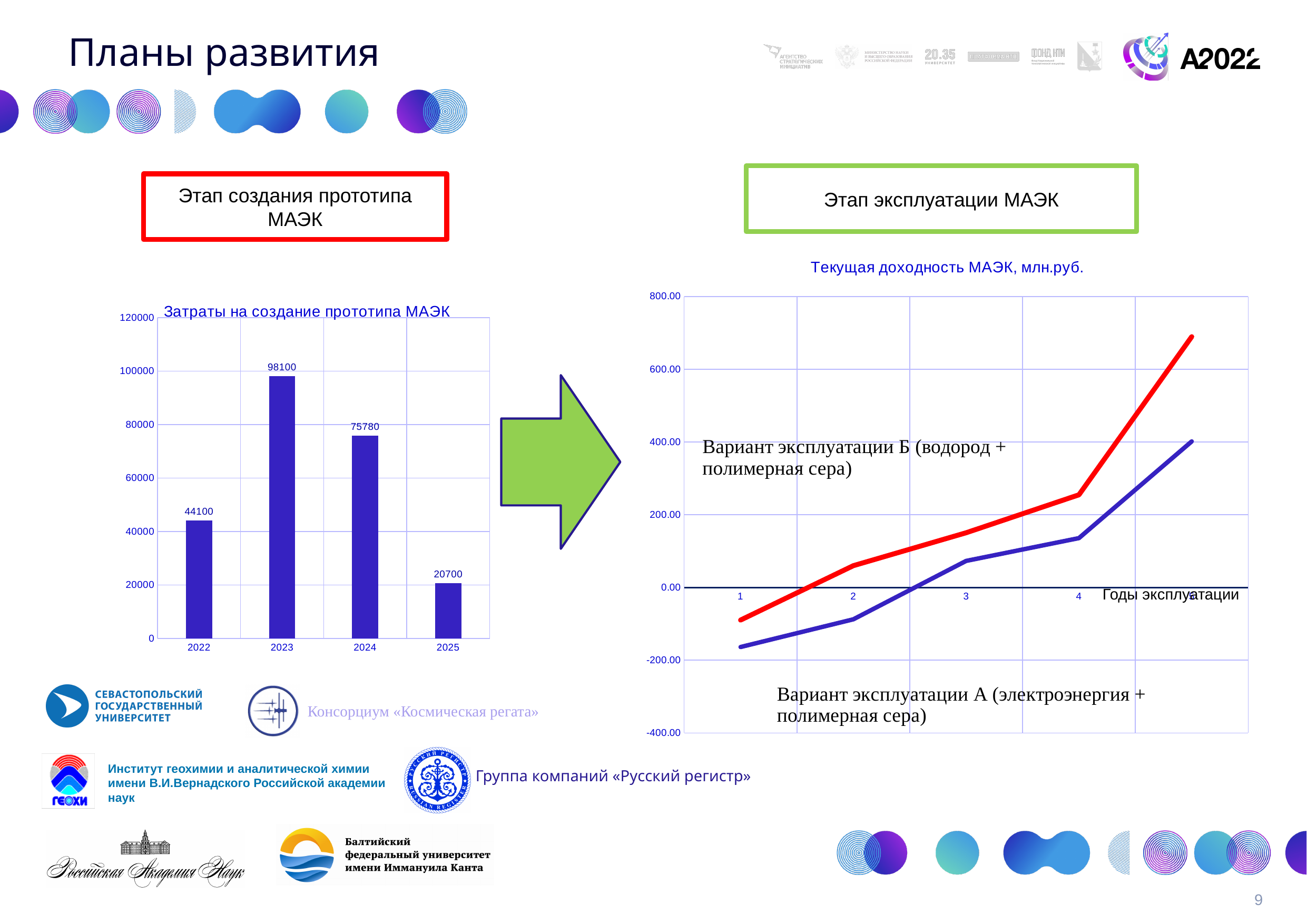
In the chart 'Затраты на создание прототипа МАЭК', which year has the lowest value? 2025 What kind of chart is 'Затраты на создание прототипа МАЭК'? bar chart In the chart 'Затраты на создание прототипа МАЭК', what is the value for 2025? 20700 In the chart 'Затраты на создание прототипа МАЭК', how many years are shown on the x axis? 4 In the chart 'Затраты на создание прототипа МАЭК', which is larger, the value for 2022 or the value for 2024? 2024 In the chart 'Текущая доходность МАЭК, млн.руб.', is the value of the red line (Вариант эксплуатации Б) at year 5 greater or less than 600.00? greater In the chart 'Текущая доходность МАЭК, млн.руб.', do the values of the red line rise or fall from year 1 to year 5? rise In the chart 'Затраты на создание прототипа МАЭК', what is the difference between the values for 2023 and 2024? 22320 In the chart 'Затраты на создание прототипа МАЭК', which year has the highest value? 2023 What kind of chart is 'Текущая доходность МАЭК, млн.руб.'? line chart In the chart 'Затраты на создание прототипа МАЭК', what is the value for 2023? 98100 In the chart 'Текущая доходность МАЭК, млн.руб.', is the value of the blue line (Вариант эксплуатации А) at year 1 greater or less than 0.00? less